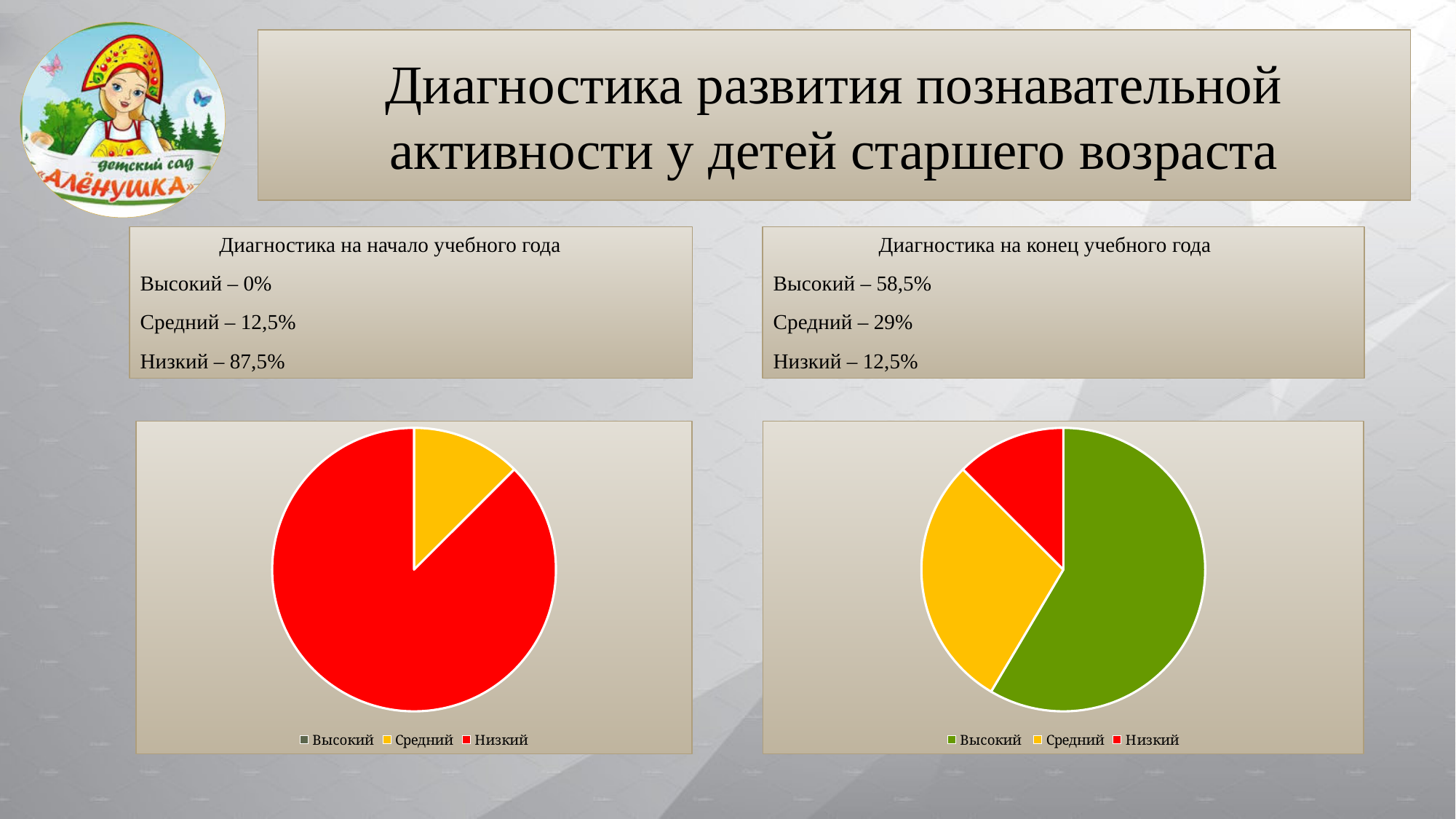
In the right chart (Диагностика на конец учебного года), what is the value for Средний? 29% In the right chart (Диагностика на конец учебного года), which is larger: Высокий or Средний? Высокий In the right chart (Диагностика на конец учебного года), what is the value for Высокий? 58,5% In the left chart (Диагностика на начало учебного года), what is the value for Низкий? 87,5% What type of chart is shown on the left side of the slide (Диагностика на начало учебного года)? pie chart In the left chart (Диагностика на начало учебного года), which category has the largest slice? Низкий In the right chart (Диагностика на конец учебного года), which category has the smallest slice? Низкий In the left chart (Диагностика на начало учебного года), what colour represents Низкий? red In the right chart (Диагностика на конец учебного года), what colour is the Высокий slice? green How many entries does the legend of the right chart (Диагностика на конец учебного года) list? 3 In the right chart (Диагностика на конец учебного года), what is the difference between Высокий and Низкий? 46% In the left chart (Диагностика на начало учебного года), what is the value for Средний? 12,5%